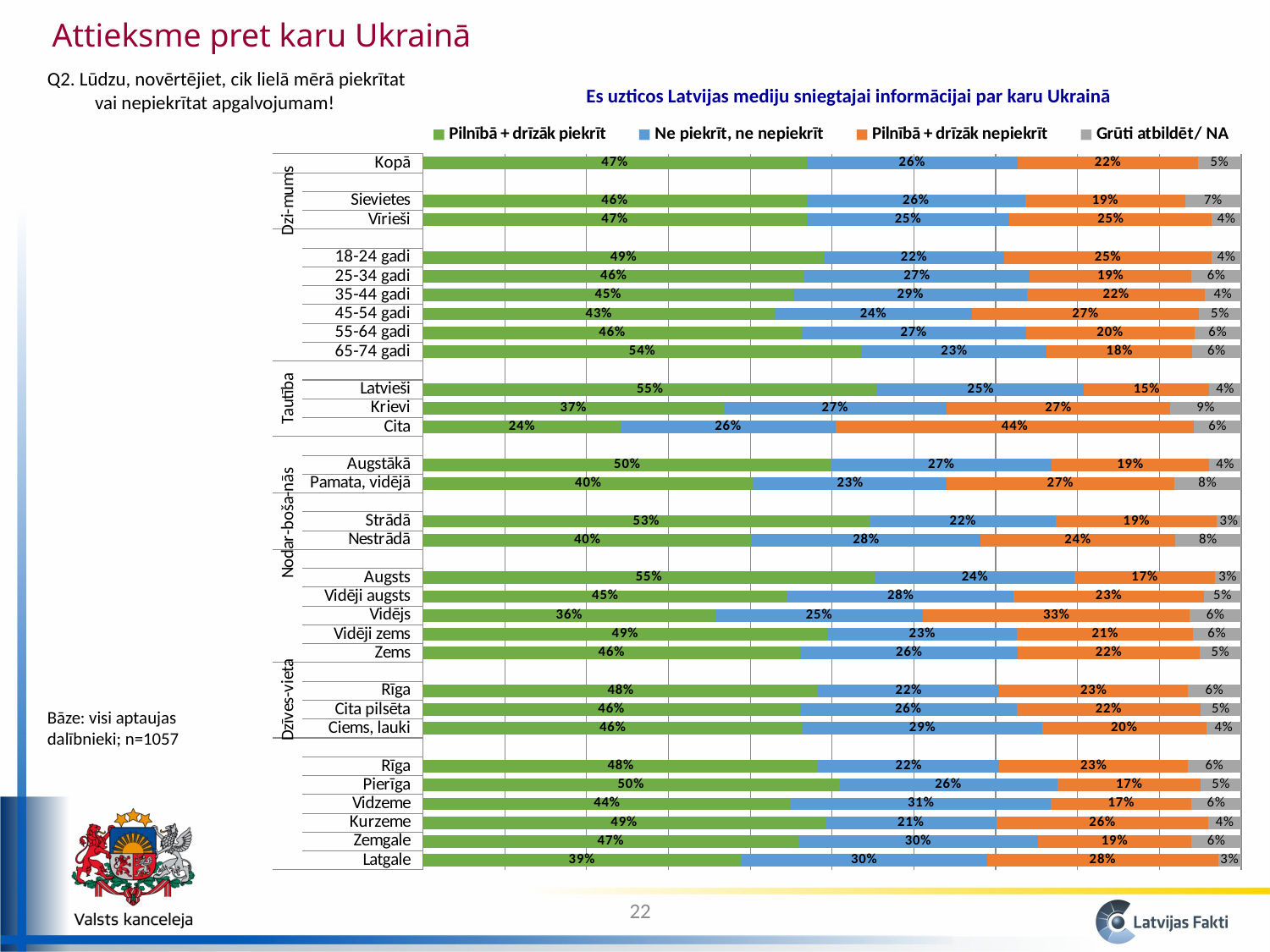
What is the value of "Pilnībā + drīzāk nepiekrīt" for Cita (Tautība)? 44% Which category has the highest value for "Pilnībā + drīzāk nepiekrīt"? Cita Which has a larger "Pilnībā + drīzāk piekrīt" value, Strādā or Nestrādā? Strādā What kind of chart is shown on the slide? Stacked bar chart What is the value of "Pilnībā + drīzāk piekrīt" for Kopā? 47% What is the title of the chart? Es uzticos Latvijas mediju sniegtajai informācijai par karu Ukrainā What is the value of "Ne piekrīt, ne nepiekrīt" for Vidzeme? 31% Which category has the lowest value for "Pilnībā + drīzāk piekrīt"? Cita What is the value of "Grūti atbildēt/ NA" for Krievi? 9% Which category has the lowest value for "Pilnībā + drīzāk nepiekrīt"? Latvieši How many series does the legend list? 4 What is the difference between the "Pilnībā + drīzāk piekrīt" values for Latvieši and Krievi? 18%